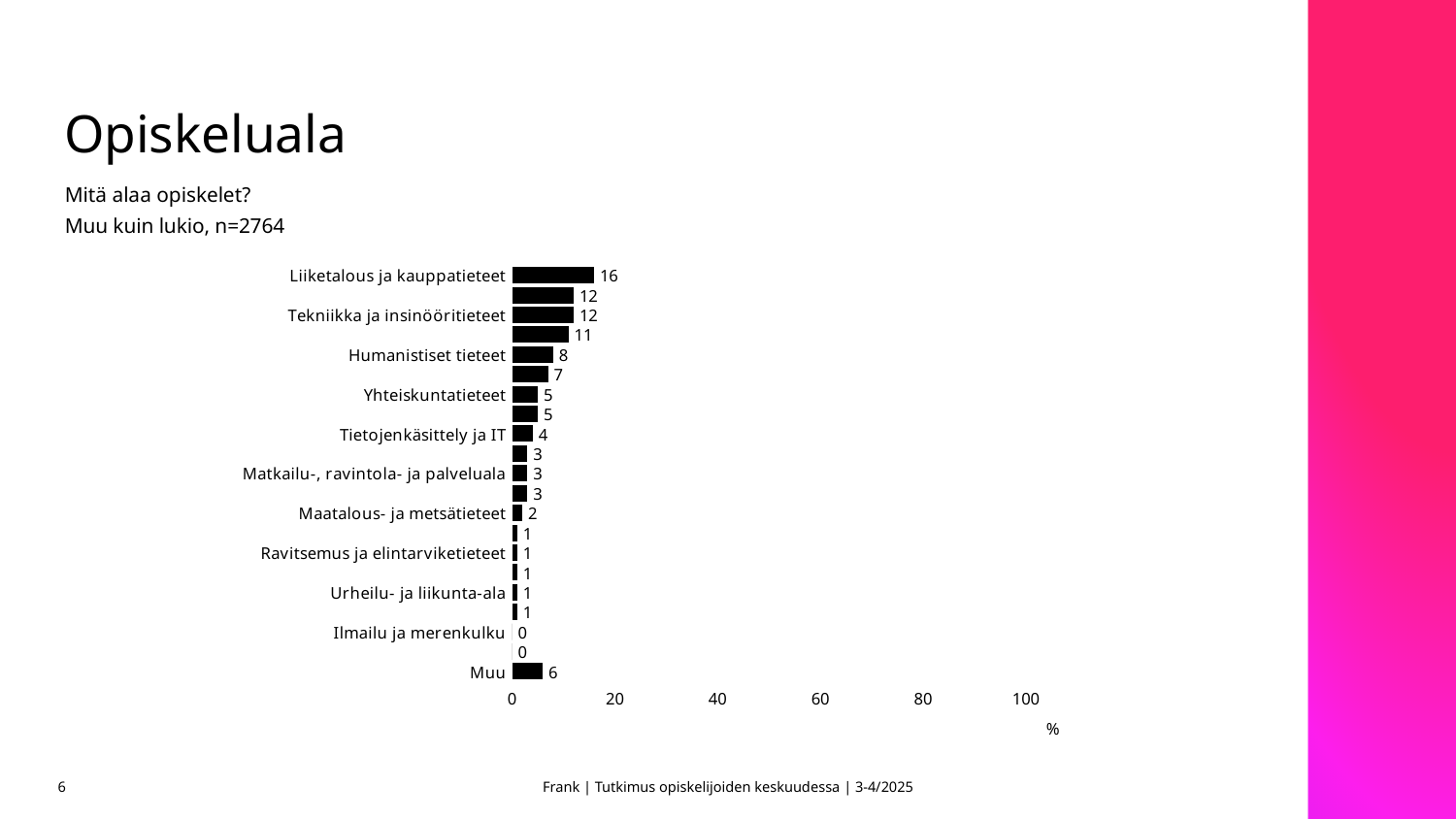
Is the value for Liiketalous ja kauppatieteet greater or less than 20? less What is the difference between Humanistiset tieteet and Yhteiskuntatieteet? 3 What is the value for Muu? 6 Which category has the highest value? Liiketalous ja kauppatieteet What unit is shown on the x axis of the chart? % What kind of chart is shown on the slide? bar chart What is the difference between Liiketalous ja kauppatieteet and Tekniikka ja insinööritieteet? 4 What is the value for Humanistiset tieteet? 8 What is the value for Ilmailu ja merenkulku? 0 Which is larger, Muu or Tietojenkäsittely ja IT? Muu What is the value for Liiketalous ja kauppatieteet? 16 What is the value for Tekniikka ja insinööritieteet? 12